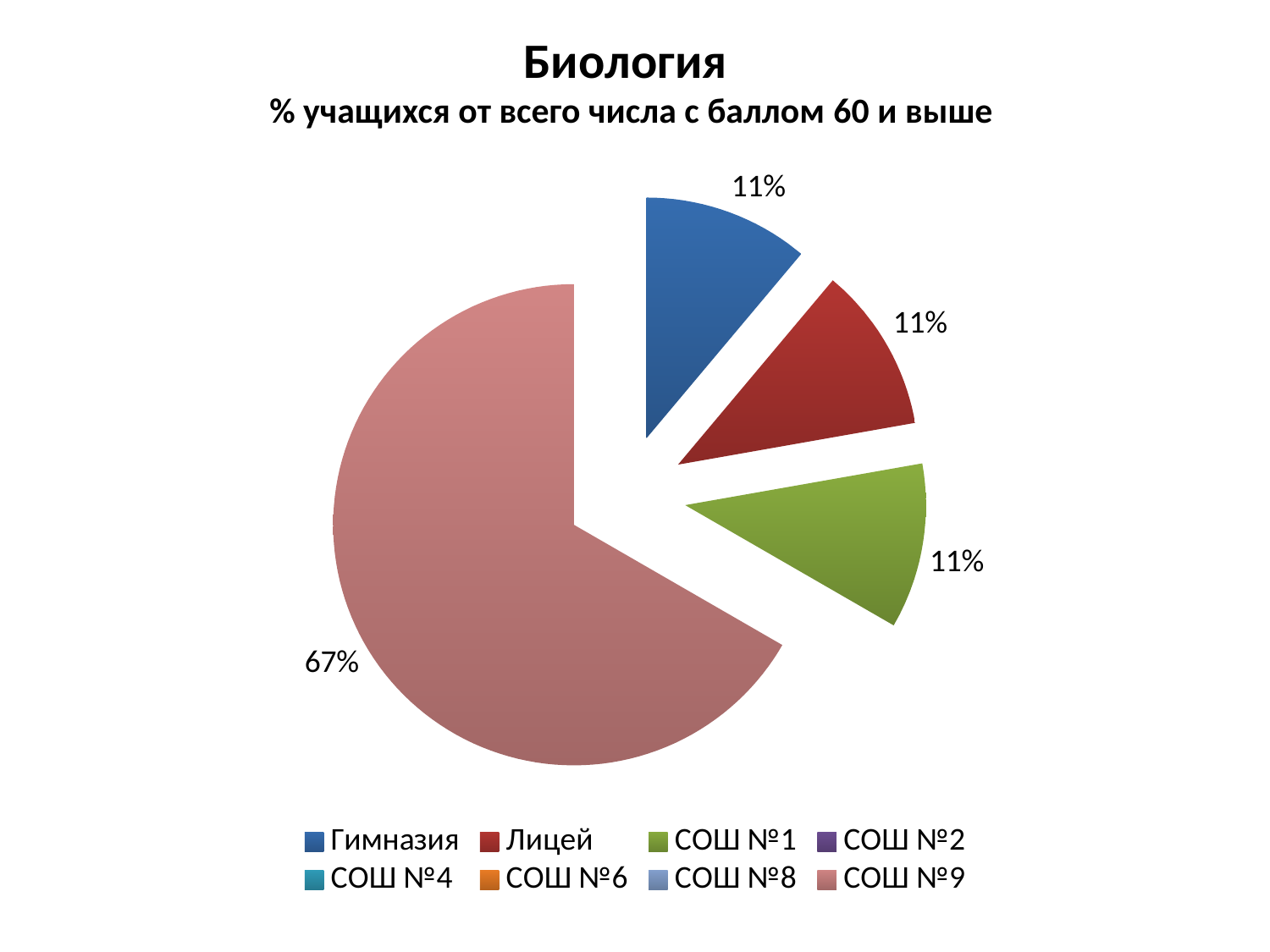
What percentage is shown for Гимназия? 11% Which category has the largest slice of the pie? СОШ №9 How many slices with data labels are visible in the pie? 4 What percentage is shown for СОШ №1? 11% What kind of chart is shown on the slide? pie chart What percentage is shown for Лицей? 11% What is the title of the chart? Биология What is the subtitle shown under the chart title? % учащихся от всего числа с баллом 60 и выше Which is larger, the slice for СОШ №9 or the slice for Лицей? СОШ №9 What percentage is shown for СОШ №9? 67% What is the difference in percentage points between СОШ №9 and Гимназия? 56 How many entries does the legend list? 8